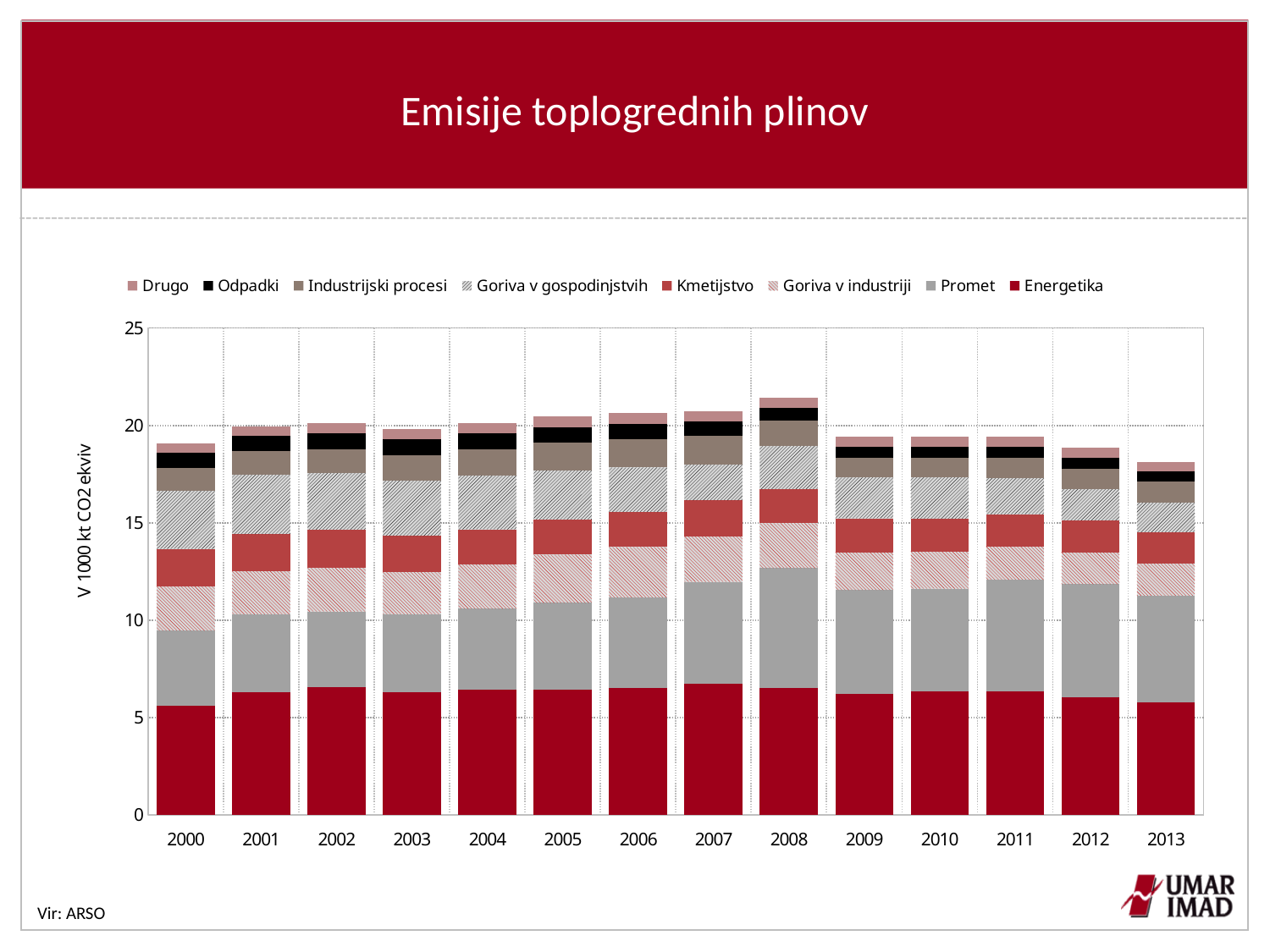
Which year has the lowest total emissions? 2013 How many series does the legend list? 8 What kind of chart is shown on the slide? Stacked bar chart Which year has a larger total, 2008 or 2013? 2008 What is the label of the vertical axis? V 1000 kt CO2 ekviv Is the Energetika value for 2000 greater or less than 5? greater What is the title of the chart? Emisije toplogrednih plinov How many years are shown on the x axis of the chart? 14 Which year has the highest total emissions? 2008 Do the total emissions rise or fall from 2008 to 2013? fall Is the total value for 2008 greater or less than 20? greater Is the total value for 2013 greater or less than 20? less